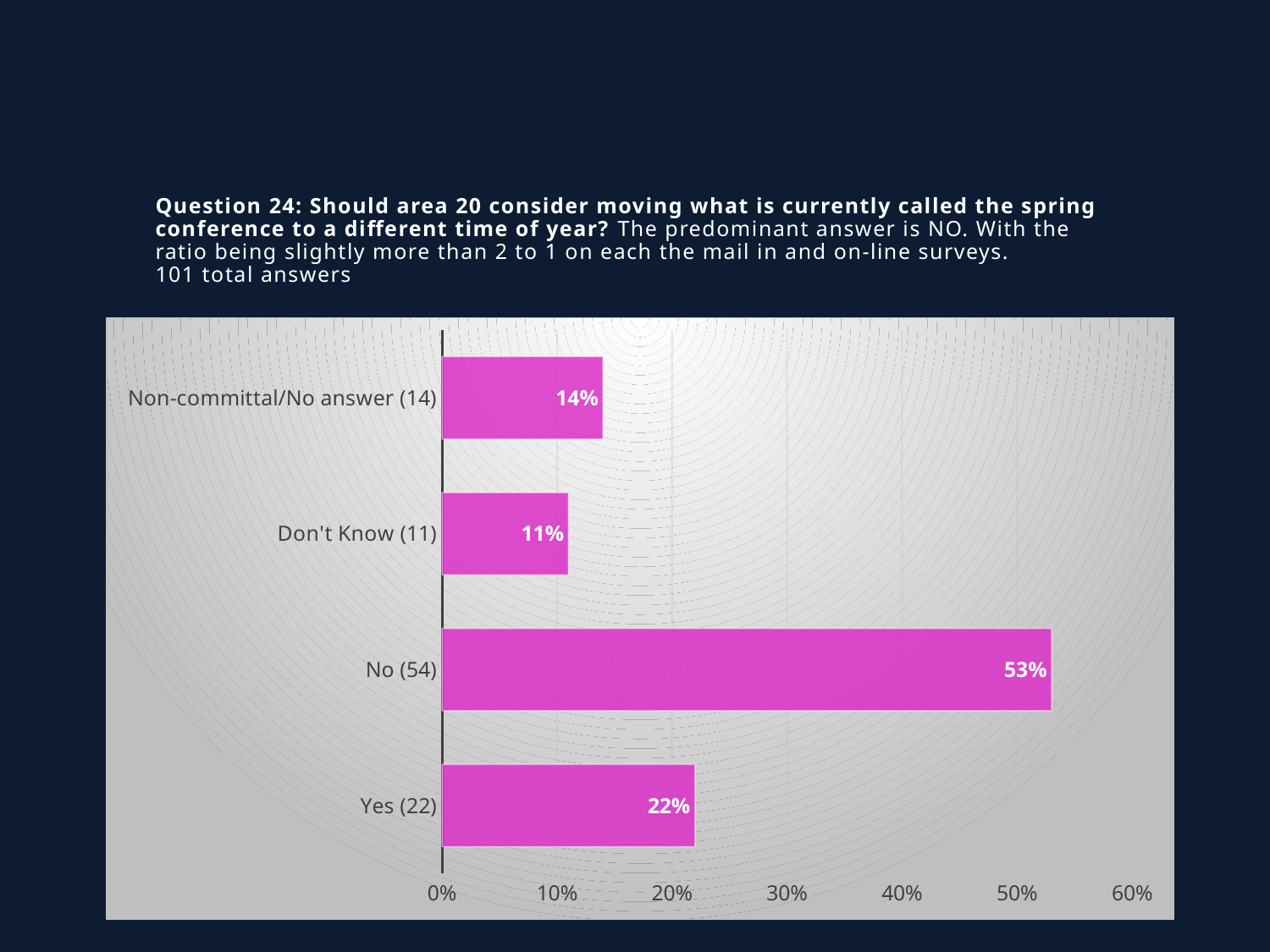
What is the value for Non-committal/No answer (14)? 14% Which category has the highest value? No (54) Which category has the lowest value? Don't Know (11) What is the highest value shown on the x axis? 60% How many categories are shown in the chart? 4 Is the value for No (54) greater or less than 50%? greater What is the value for No (54)? 53% Which is larger, the value for Yes (22) or the value for Non-committal/No answer (14)? Yes (22) What is the value for Don't Know (11)? 11% What is the difference between the values for No (54) and Yes (22)? 31% What is the value for Yes (22)? 22% What kind of chart is shown on the slide? bar chart